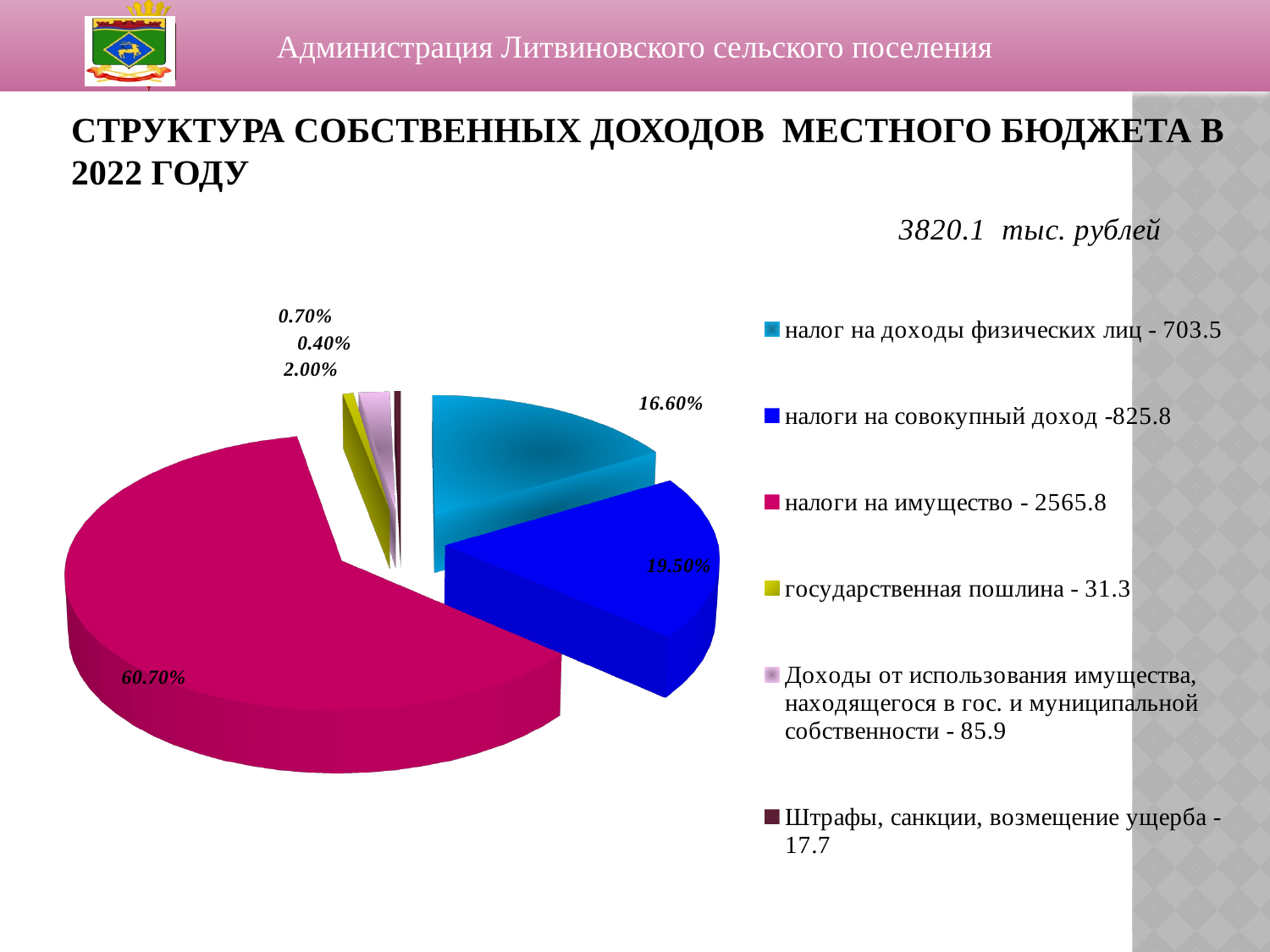
What share of the pie does the slice for налоги на имущество represent? 60.70% Which is larger: the slice for налоги на совокупный доход or the slice for налог на доходы физических лиц? налоги на совокупный доход What value is given in the legend for Штрафы, санкции, возмещение ущерба? 17.7 Which category has the smallest value in the legend? Штрафы, санкции, возмещение ущерба How many categories does the legend of the pie chart list? 6 What kind of chart is shown on the slide? pie chart What value is given in the legend for налоги на имущество? 2565.8 What value is given in the legend for государственная пошлина? 31.3 Which category has the largest slice of the pie? налоги на имущество What total amount in thousand rubles is shown above the chart? 3820.1 тыс. рублей What share of the pie does the slice for налоги на совокупный доход represent? 19.50% What share of the pie does the slice for налог на доходы физических лиц represent? 16.60%